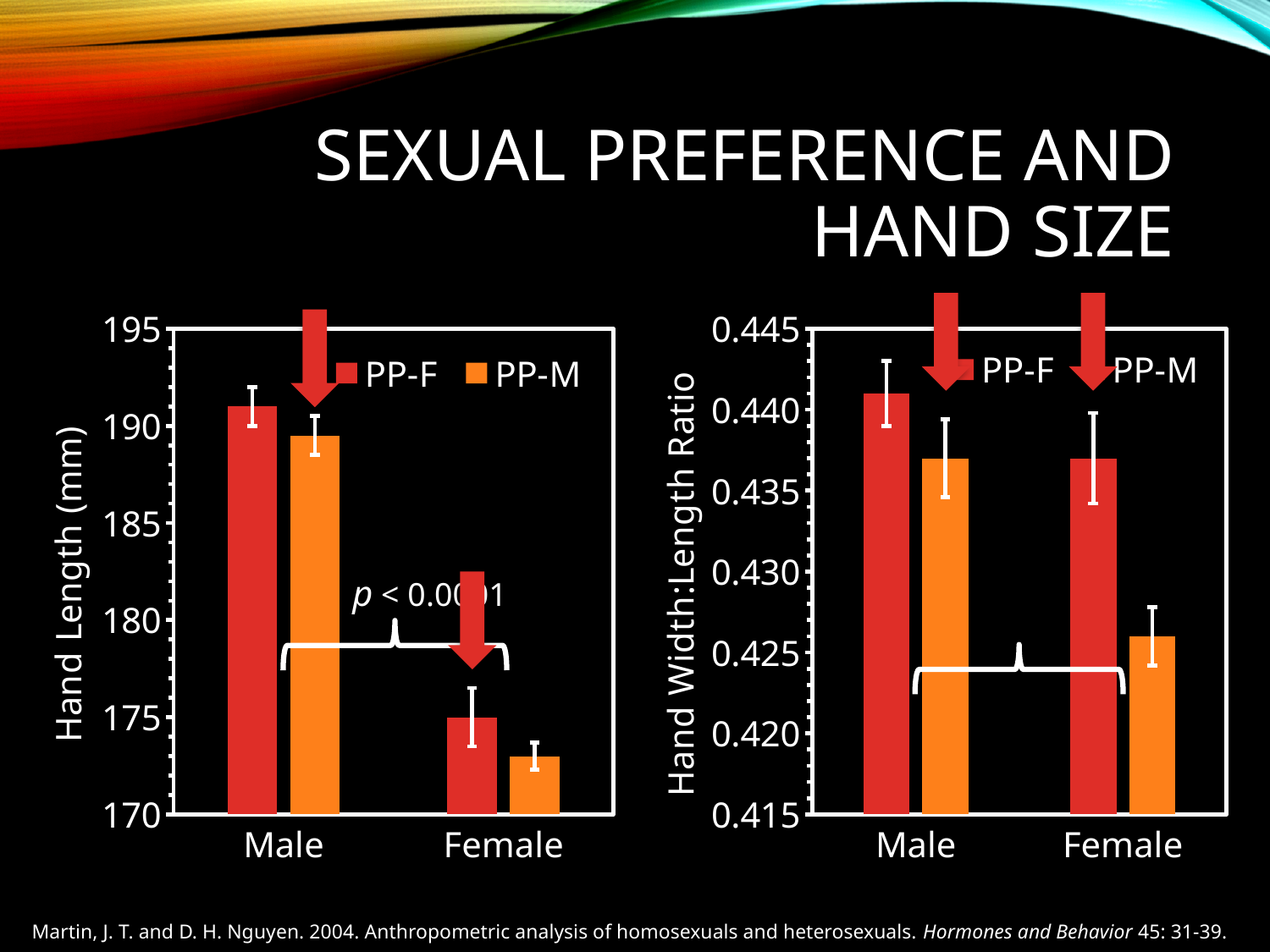
In the left chart, Hand Length (mm), which bar is the highest? PP-F, Male In the right chart, Hand Width:Length Ratio, is the value for PP-M in the Female category greater or less than 0.430? less What is the y-axis title of the right chart? Hand Width:Length Ratio In the right chart, Hand Width:Length Ratio, is the value for PP-F in the Male category greater or less than 0.435? greater In the right chart, Hand Width:Length Ratio, which is larger: PP-F for Male or PP-M for Female? PP-F for Male In the left chart, Hand Length (mm), is the value for PP-F in the Male category greater or less than 185? greater How many categories are shown on the x axis of the left chart, Hand Length (mm)? 2 In the left chart, do the PP-F values rise or fall from Male to Female? fall In the left chart, Hand Length (mm), which bar is the lowest? PP-M, Female How many series does the legend list in the right chart, Hand Width:Length Ratio? 2 What kind of chart is the left chart, Hand Length (mm)? bar chart